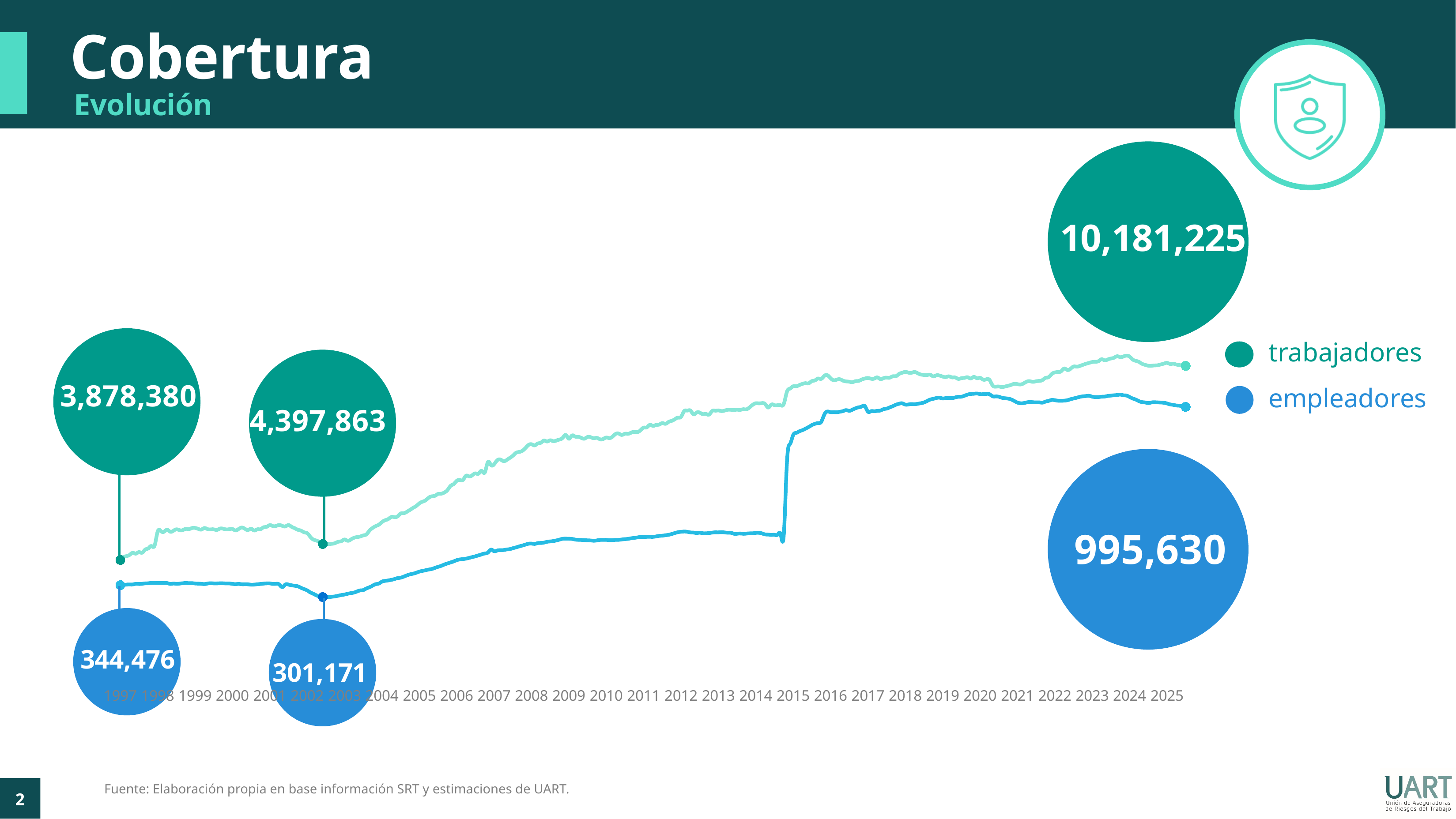
What are the two series named in the legend? trabajadores and empleadores How many series does the legend list? 2 What is the lowest labelled value for empleadores? 301,171 In 2025, which series has the larger value, trabajadores or empleadores? trabajadores By how much does the trabajadores value in 2025 exceed the trabajadores value in 1997? 6,302,845 What is the labelled value for empleadores in 2025? 995,630 What is the labelled value for trabajadores in 2025? 10,181,225 What is the labelled value for empleadores in 1997? 344,476 By how much does the empleadores value in 2025 exceed the empleadores value in 1997? 651,154 What is the labelled value for trabajadores in 1997? 3,878,380 Does the trabajadores line overall rise or fall from 1997 to 2025? rise What kind of chart is shown on the slide? line chart